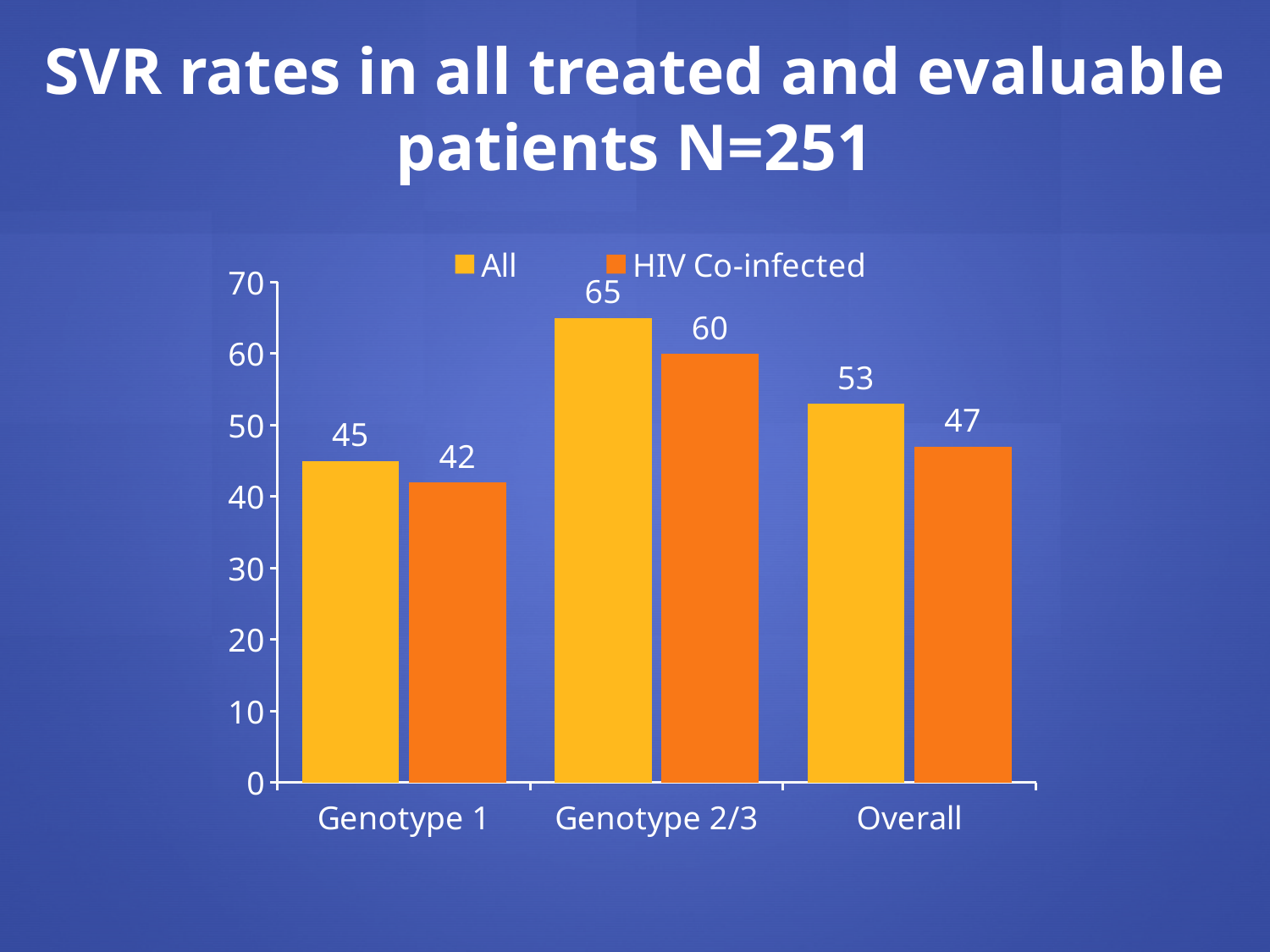
What kind of chart is shown on the slide? Bar chart How many series does the legend list? 2 What is the SVR rate for HIV Co-infected patients in Genotype 2/3? 60 How many categories are shown on the x axis? 3 What is the Overall SVR rate for the All series? 53 What is the SVR rate for the All series in Genotype 1? 45 Which category has the lowest value for the HIV Co-infected series? Genotype 1 What is the difference between the All and HIV Co-infected values for Overall? 6 Which is larger in Genotype 1: the All value or the HIV Co-infected value? All What are the two series named in the legend? All and HIV Co-infected What is the difference between the All values for Genotype 2/3 and Genotype 1? 20 Which category has the highest value for the All series? Genotype 2/3